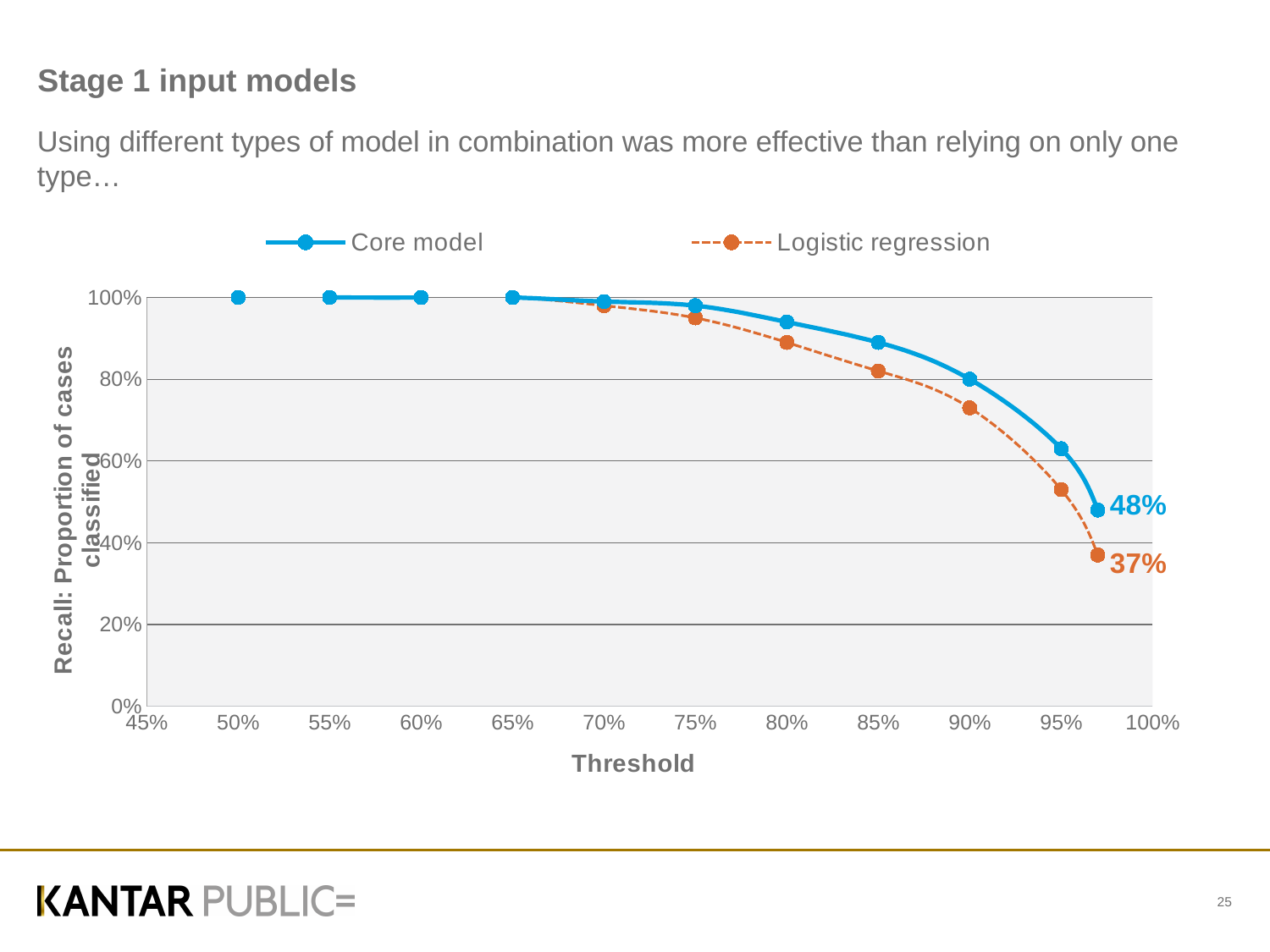
At the highest threshold plotted, which series has the higher recall: Core model or Logistic regression? Core model What is the Core model recall at the 50% threshold? 100% What is the title of the x axis? Threshold Is the Core model recall at the 85% threshold greater or less than 80%? greater What type of chart is shown on the slide? Line chart Is the Logistic regression recall at the 90% threshold greater or less than 80%? less How many series does the legend list? 2 What is the difference between the labelled end values of the Core model (48%) and Logistic regression (37%) lines? 11 percentage points What is the labelled recall value at the end of the Core model line? 48% As the threshold increases along the x axis, does recall rise or fall? Fall What is the labelled recall value at the end of the Logistic regression line? 37%